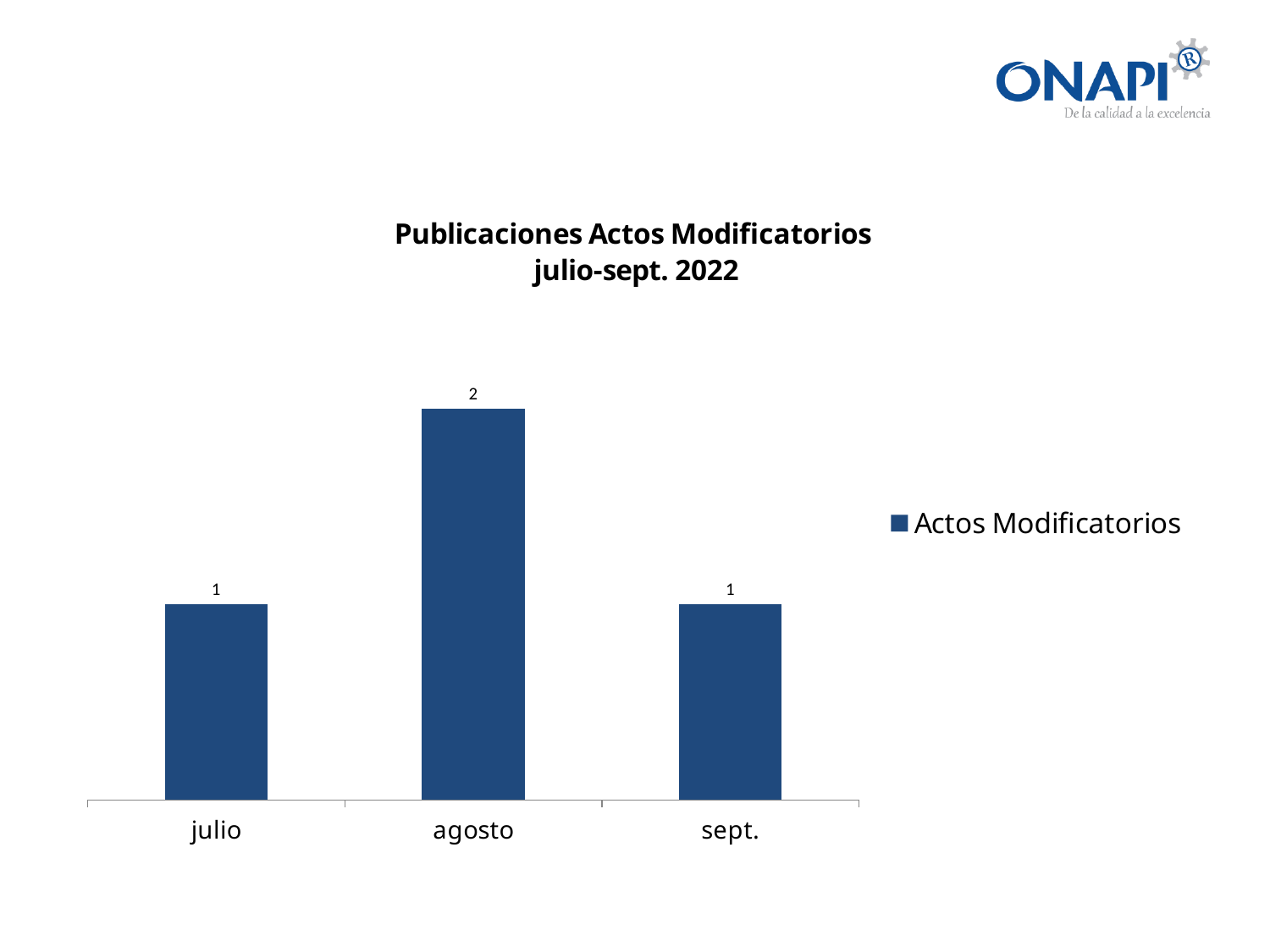
What is the title of the chart? Publicaciones Actos Modificatorios julio-sept. 2022 What is the value for sept.? 1 Which is larger, the value for agosto or the value for sept.? agosto How many months are shown on the x axis? 3 Which month has the highest value? agosto What is the value for julio? 1 How many series does the legend list? 1 What is the difference between the values for agosto and julio? 1 What is the value for agosto? 2 What kind of chart is shown? bar chart What series name does the legend show? Actos Modificatorios What is the total of the values for julio, agosto and sept.? 4